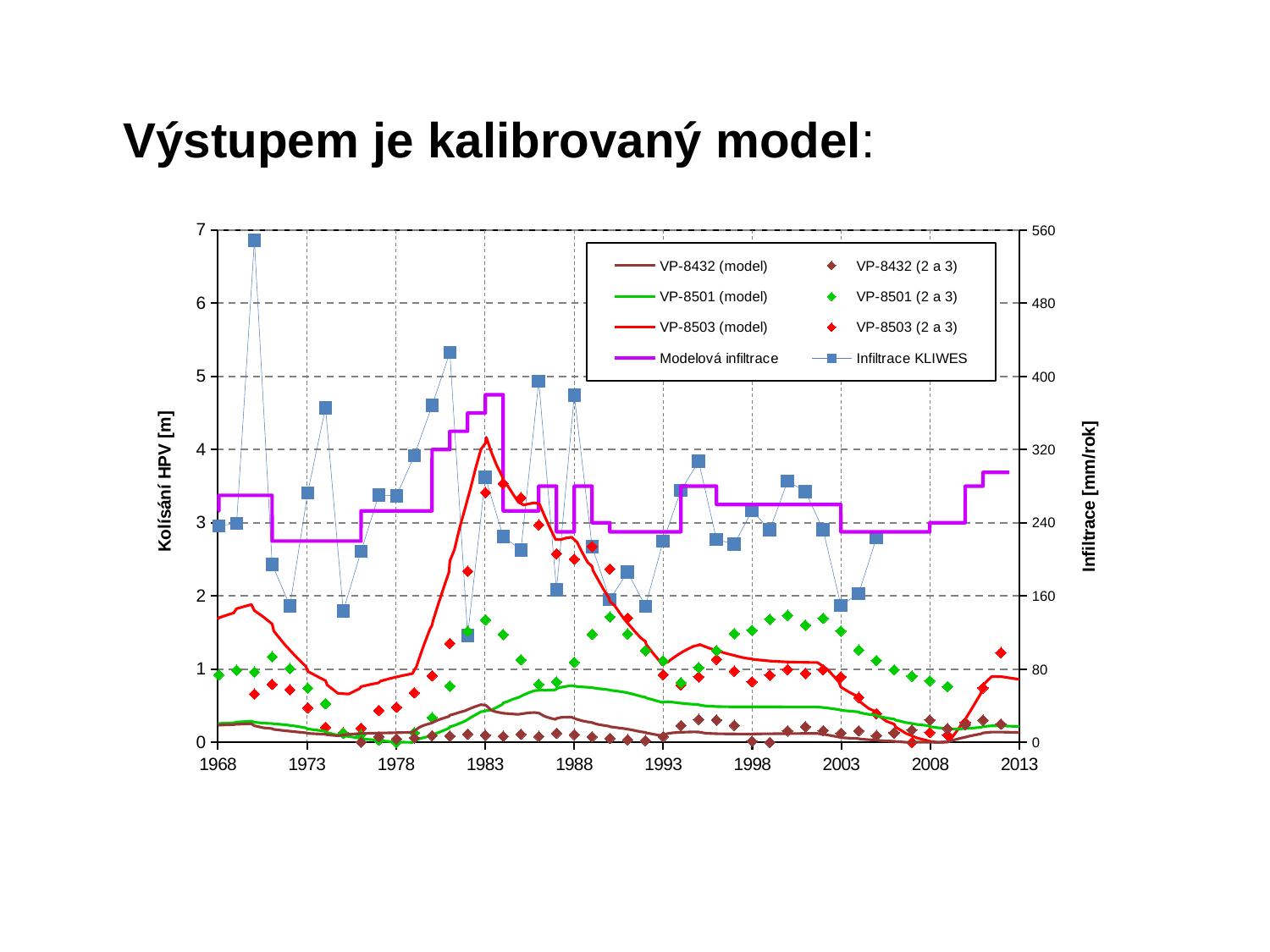
Which is larger in 1983, the VP-8503 (model) value or the VP-8432 (model) value? VP-8503 (model) Does the VP-8503 (model) line rise or fall between 1983 and 1993? fall Does the VP-8501 (model) line rise or fall between 1978 and 1988? rise How many series does the chart legend list? 8 Is the Modelová infiltrace value in 1973 greater or less than 240 mm/rok? less What is the label of the right vertical axis? Infiltrace [mm/rok] In which year does the VP-8503 (model) line reach its highest value? 1983 Is the Infiltrace KLIWES value in 1970 greater or less than 480 mm/rok? greater What is the label of the left vertical axis? Kolísání HPV [m] In which year does the Infiltrace KLIWES series reach its highest value? 1970 Is the VP-8503 (model) value in 1983 greater or less than 4 m? greater What kind of chart is shown on the slide? line chart